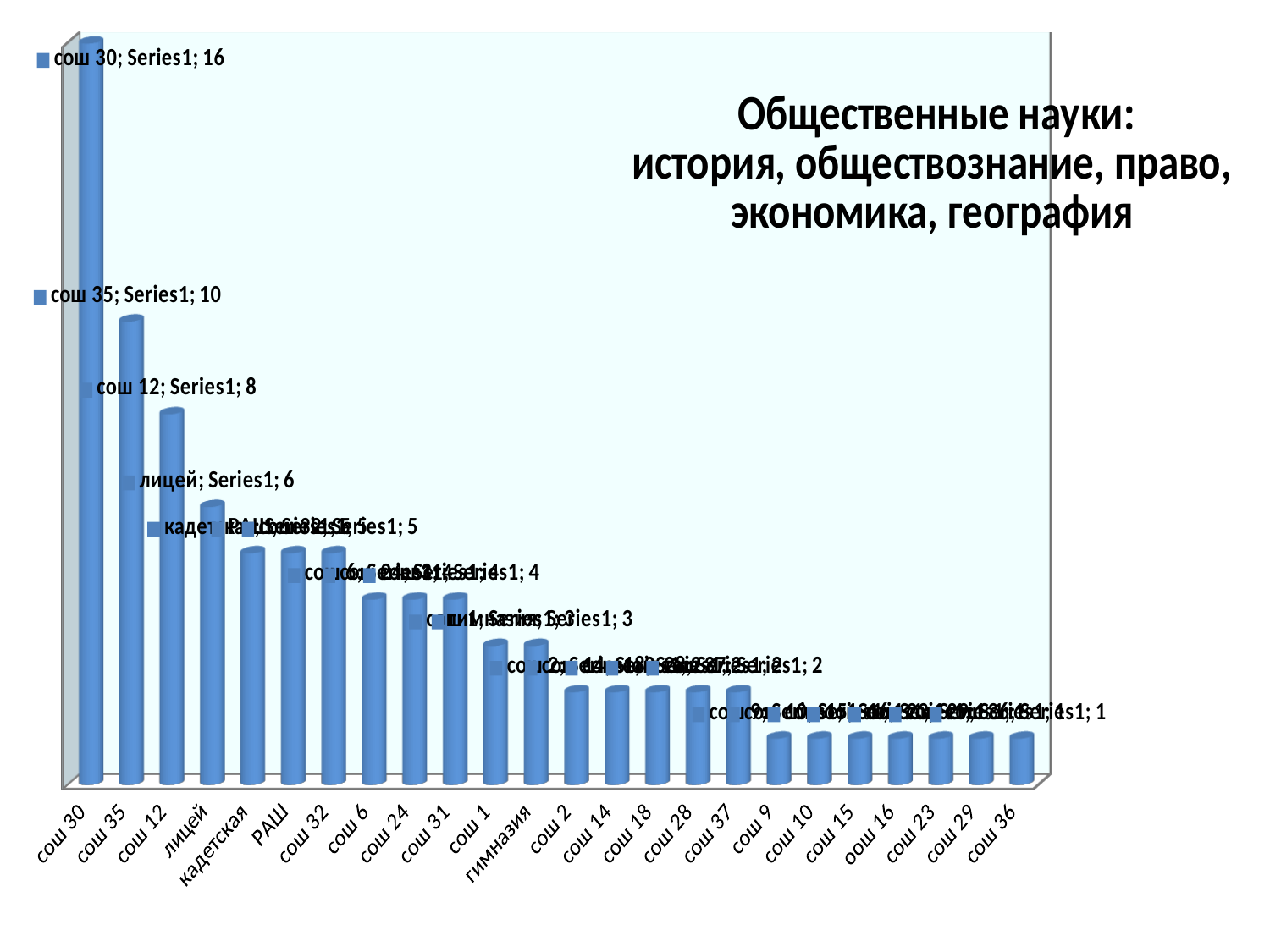
What is the difference between the values for сош 30 and сош 35? 6 What is the value for сош 30? 16 What is the difference between the values for сош 12 and лицей? 2 How many categories are shown on the x axis? 24 What is the value for сош 35? 10 What is the value for лицей? 6 Which category has the highest value? сош 30 What kind of chart is shown on the slide? bar chart What is the value for сош 12? 8 Which is larger, the value for сош 35 or the value for сош 12? сош 35 What is the smallest value shown on the chart? 1 Do the values rise or fall from left to right along the x axis? fall